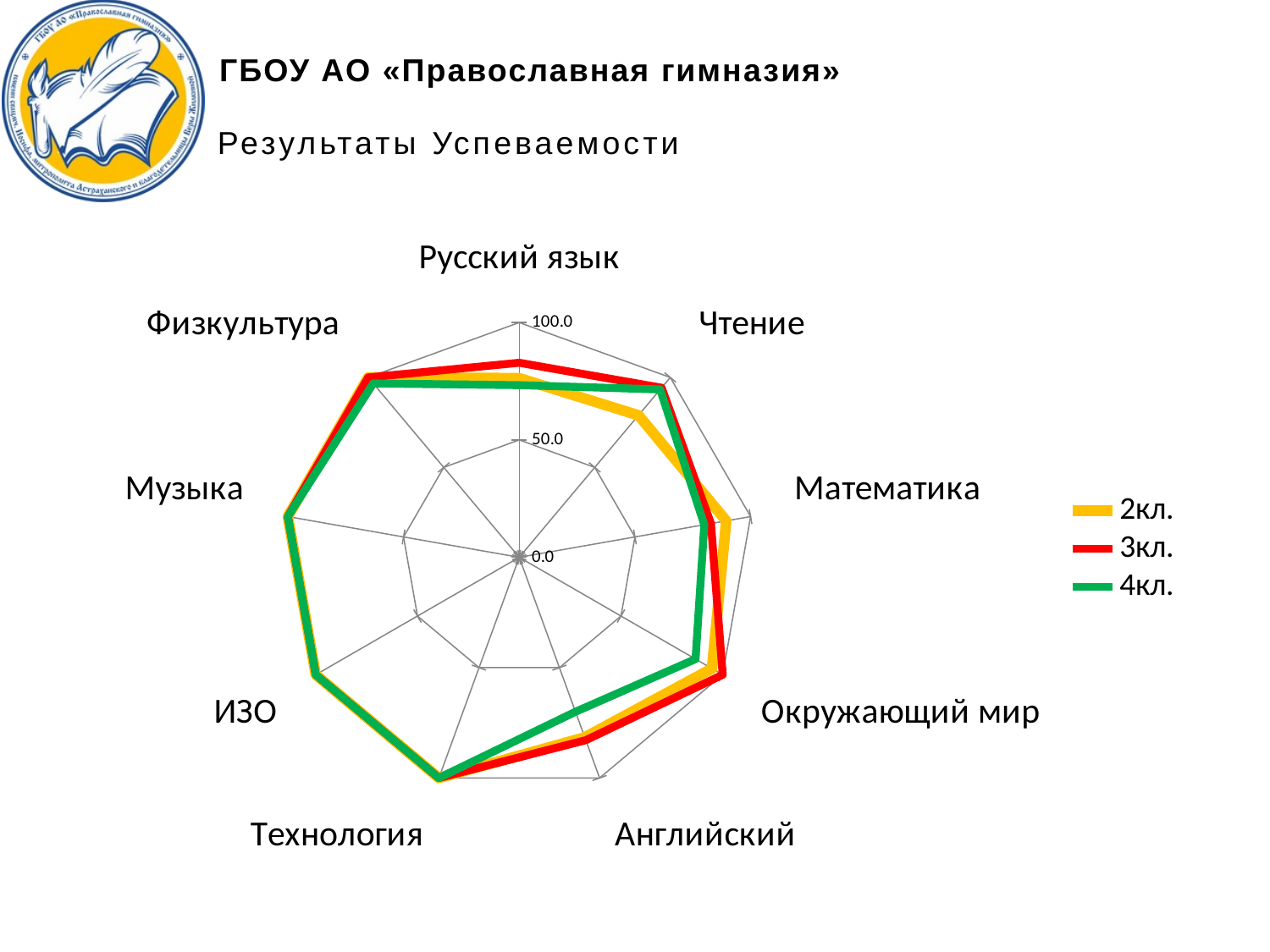
For Математика, which is larger: the value for 2кл. or for 4кл.? 2кл. For Русский язык, which is larger: the value for 2кл. or for 3кл.? 3кл. What kind of chart is shown on the slide? radar chart How many series does the legend list? 3 How many subject categories are plotted on the radar chart? 9 For Окружающий мир, which is larger: the value for 3кл. or for 4кл.? 3кл. Is the value for Технология for 4кл. greater or less than 50.0? greater What is the highest value shown on the radar chart's axis? 100.0 Is the value for Русский язык for 2кл. greater or less than 50.0? greater Is the value for Английский for 3кл. greater or less than 50.0? greater Which series does the legend show in red? 3кл.